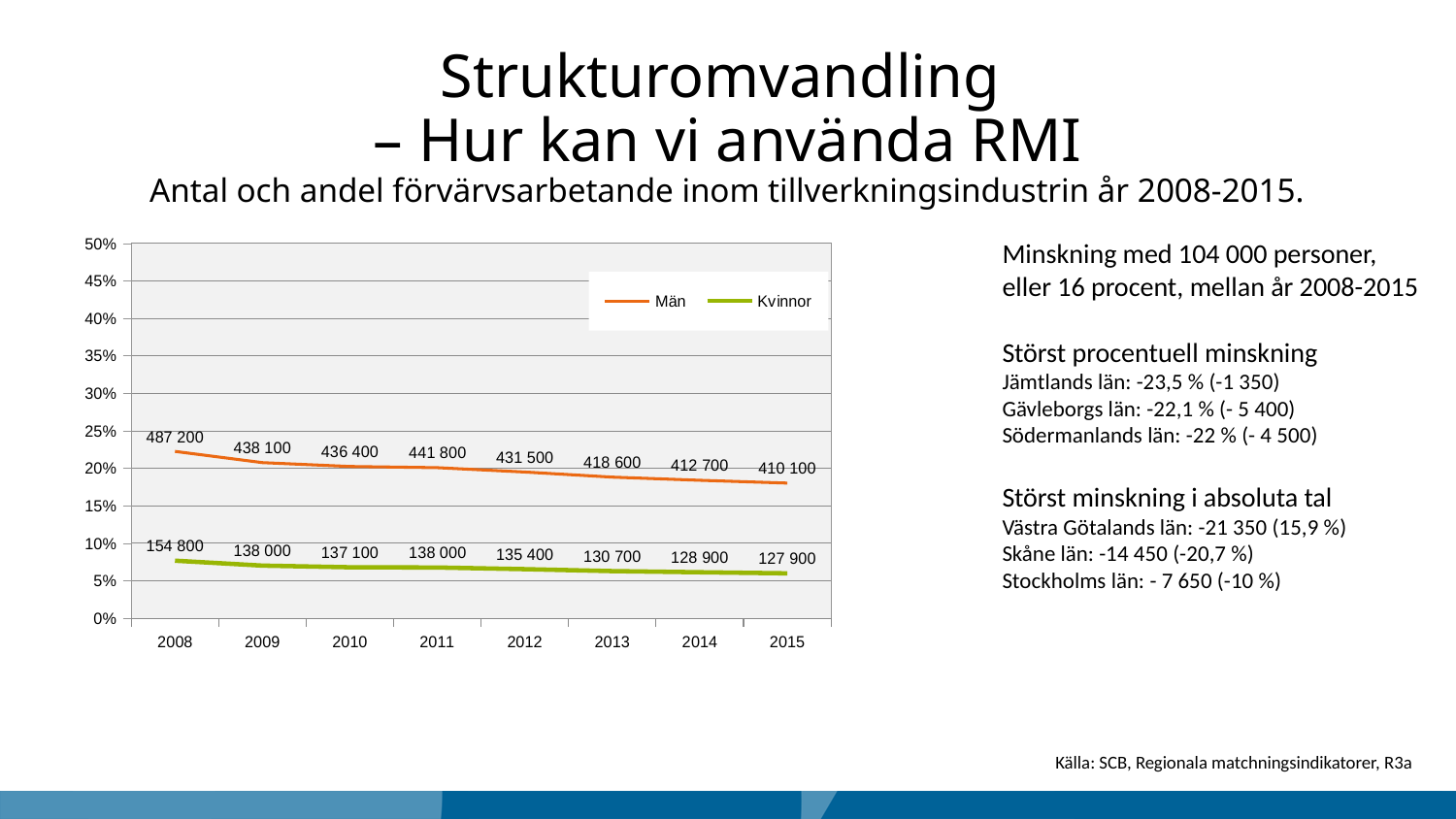
In which year is the Män data label highest? 2008 What is the data label for Män in 2011? 441 800 How many series does the legend list? 2 What is the data label for Kvinnor in 2012? 135 400 Is the plotted value for Män in 2008 greater or less than 20%? greater How many years are shown on the x axis? 8 Which is larger, the Kvinnor data label for 2009 or for 2013? 2009 What is the data label for Kvinnor in 2015? 127 900 What is the difference between the Män data labels for 2008 and 2015? 77 100 What is the data label for Män in 2008? 487 200 What kind of chart is shown on the slide? line chart In which year is the Kvinnor data label lowest? 2015